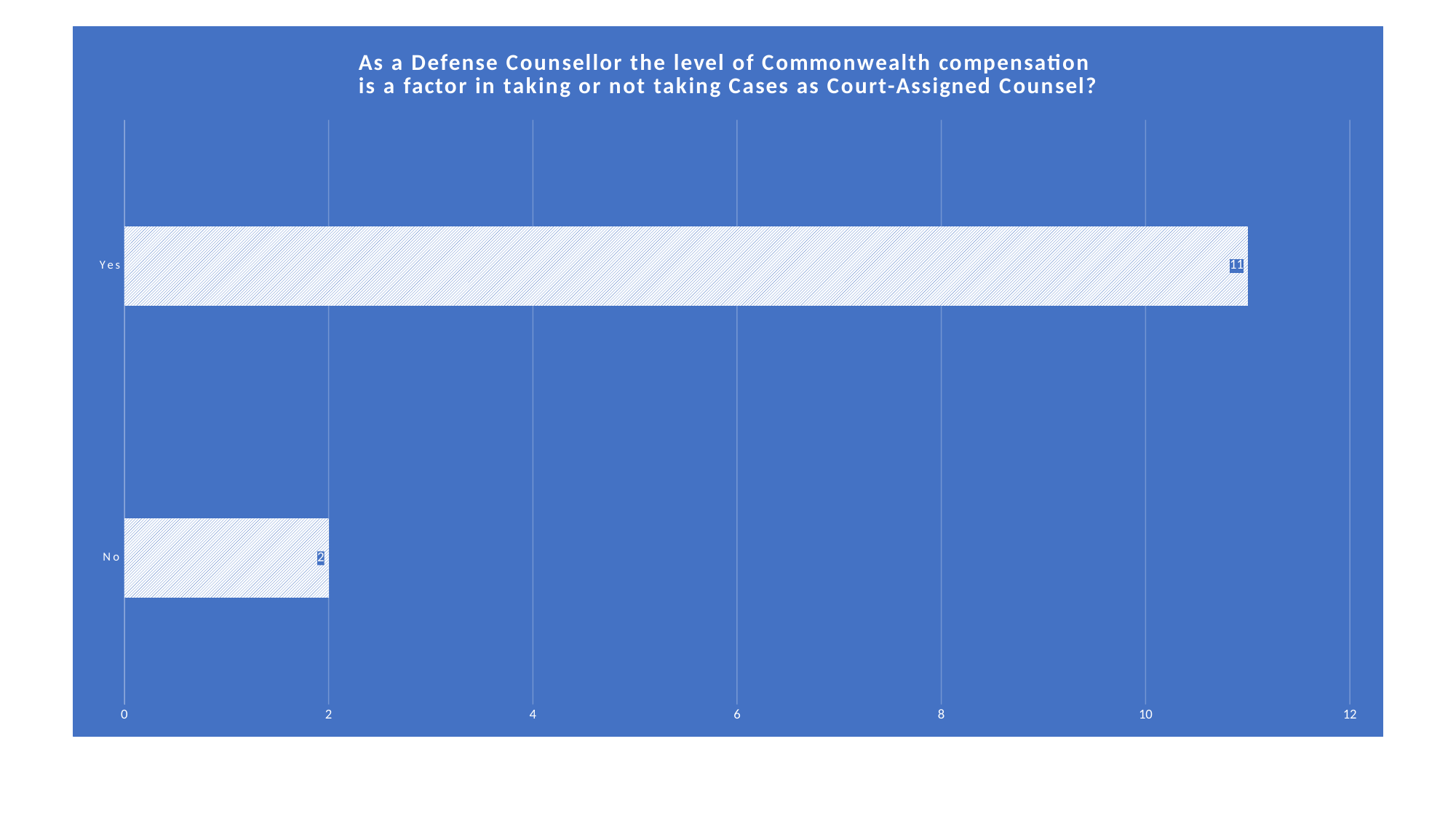
What kind of chart is shown on the slide? bar chart Which category has the highest value? Yes What is the value for No? 2 What is the highest value shown on the horizontal axis? 12 Which is larger, the value for Yes or the value for No? Yes What is the total of the values for Yes and No? 13 How many categories are shown in the chart? 2 Is the value for Yes greater or less than 10? greater Is the value for No greater or less than 4? less What is the value for Yes? 11 Which category has the lowest value? No What is the difference between the values for Yes and No? 9